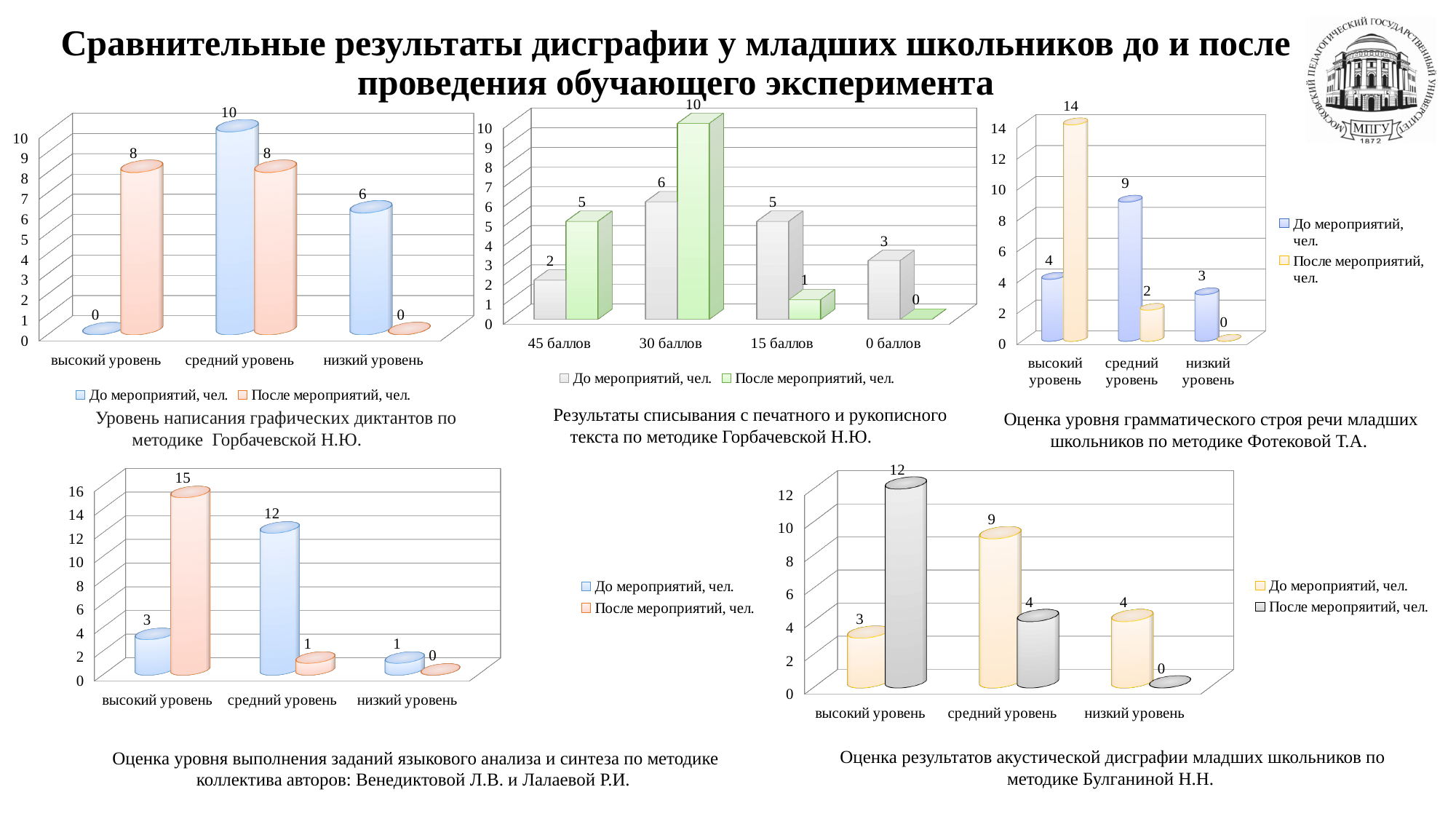
In the top-left chart (Уровень написания графических диктантов), what is the value for 'средний уровень' in the 'До мероприятий, чел.' series? 10 In the top-middle chart (Результаты списывания с печатного и рукописного текста), what is the value for '30 баллов' in the 'После мероприятий, чел.' series? 10 In the bottom-right chart (Оценка результатов акустической дисграфии), what is the difference between the 'После мероприятий' and 'До мероприятий' values for 'высокий уровень'? 9 In the top-left chart (Уровень написания графических диктантов), what is the difference between the 'После мероприятий' and 'До мероприятий' values for 'высокий уровень'? 8 How many series does the legend of the bottom-right chart (Оценка результатов акустической дисграфии) list? 2 In the bottom-left chart (Оценка уровня выполнения заданий языкового анализа и синтеза), what is the value for 'высокий уровень' in the 'После мероприятий, чел.' series? 15 In the bottom-left chart (Оценка уровня выполнения заданий языкового анализа и синтеза), which is larger for 'средний уровень': the 'До мероприятий' value or the 'После мероприятий' value? До мероприятий In the top-right chart (Оценка уровня грамматического строя речи), which category has the highest 'До мероприятий, чел.' value? средний уровень In the top-middle chart (Результаты списывания с печатного и рукописного текста), which category has the lowest 'До мероприятий, чел.' value? 45 баллов In the top-right chart (Оценка уровня грамматического строя речи), what is the value for 'высокий уровень' in the 'После мероприятий, чел.' series? 14 In the bottom-right chart (Оценка результатов акустической дисграфии), what is the value for 'средний уровень' in the 'До мероприятий, чел.' series? 9 In the top-middle chart (Результаты списывания с печатного и рукописного текста), how many categories are shown on the x axis? 4